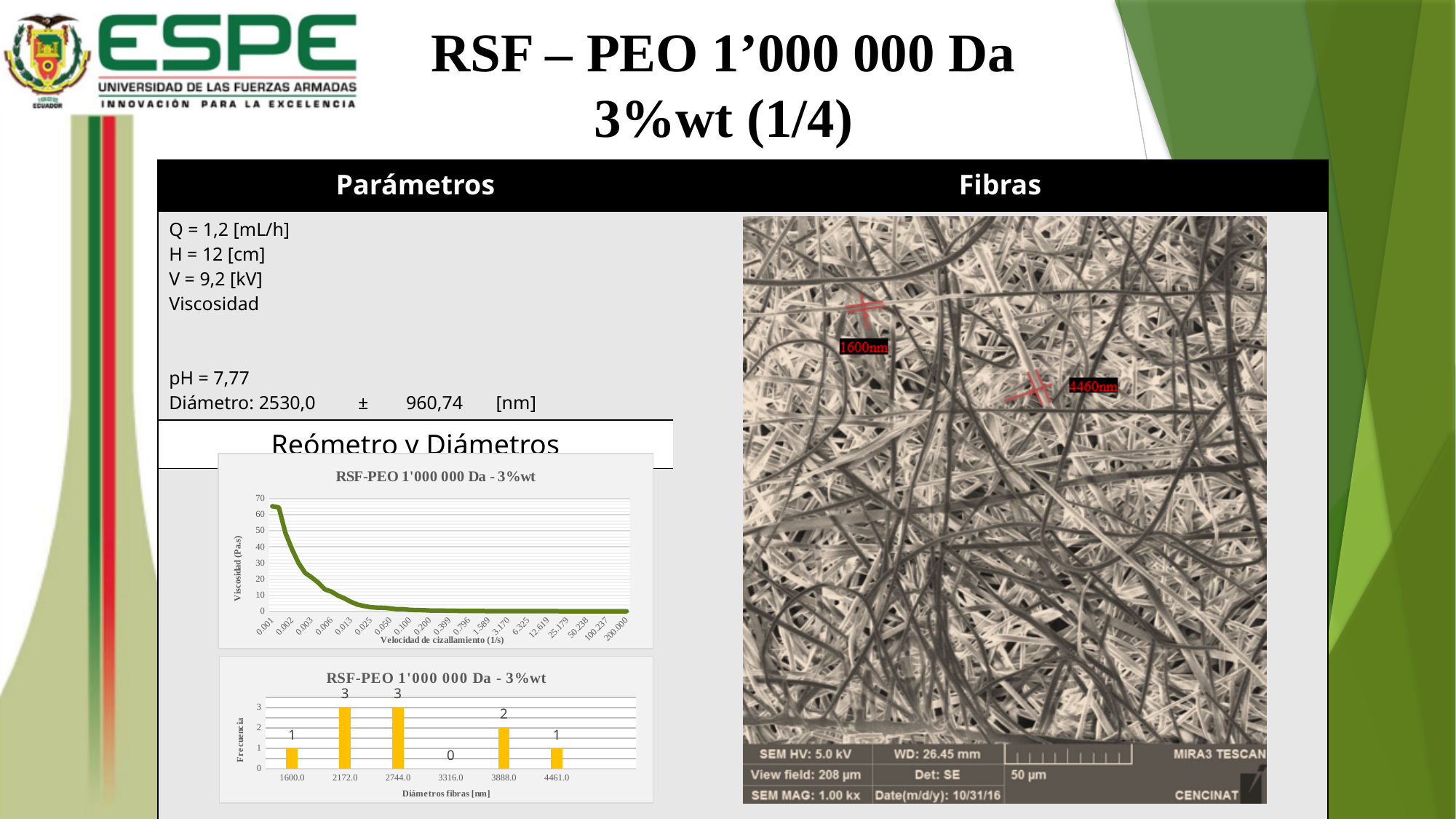
In the lower bar chart, which is larger: the frequency at 1600.0 or the frequency at 3888.0? 3888.0 In the lower bar chart, what is the frequency for the 3316.0 nm diameter? 0 In the upper line chart, is the viscosity at a shear rate of 0.001 greater or less than 60? greater In the lower bar chart, what is the frequency for the 3888.0 nm diameter? 2 In the lower bar chart, which diameter category has the lowest frequency? 3316.0 In the lower bar chart, what is the difference between the frequency at 2744.0 and the frequency at 4461.0? 2 How many diameter categories are shown in the lower bar chart? 6 In the upper line chart, does viscosity rise or fall as shear rate increases along the x axis? fall In the lower bar chart, what is the frequency for the 2172.0 nm diameter? 3 What kind of chart is the lower chart on the slide? bar chart What is the y-axis label of the upper line chart? Viscosidad (Pa.s) What kind of chart is the upper chart on the slide? line chart